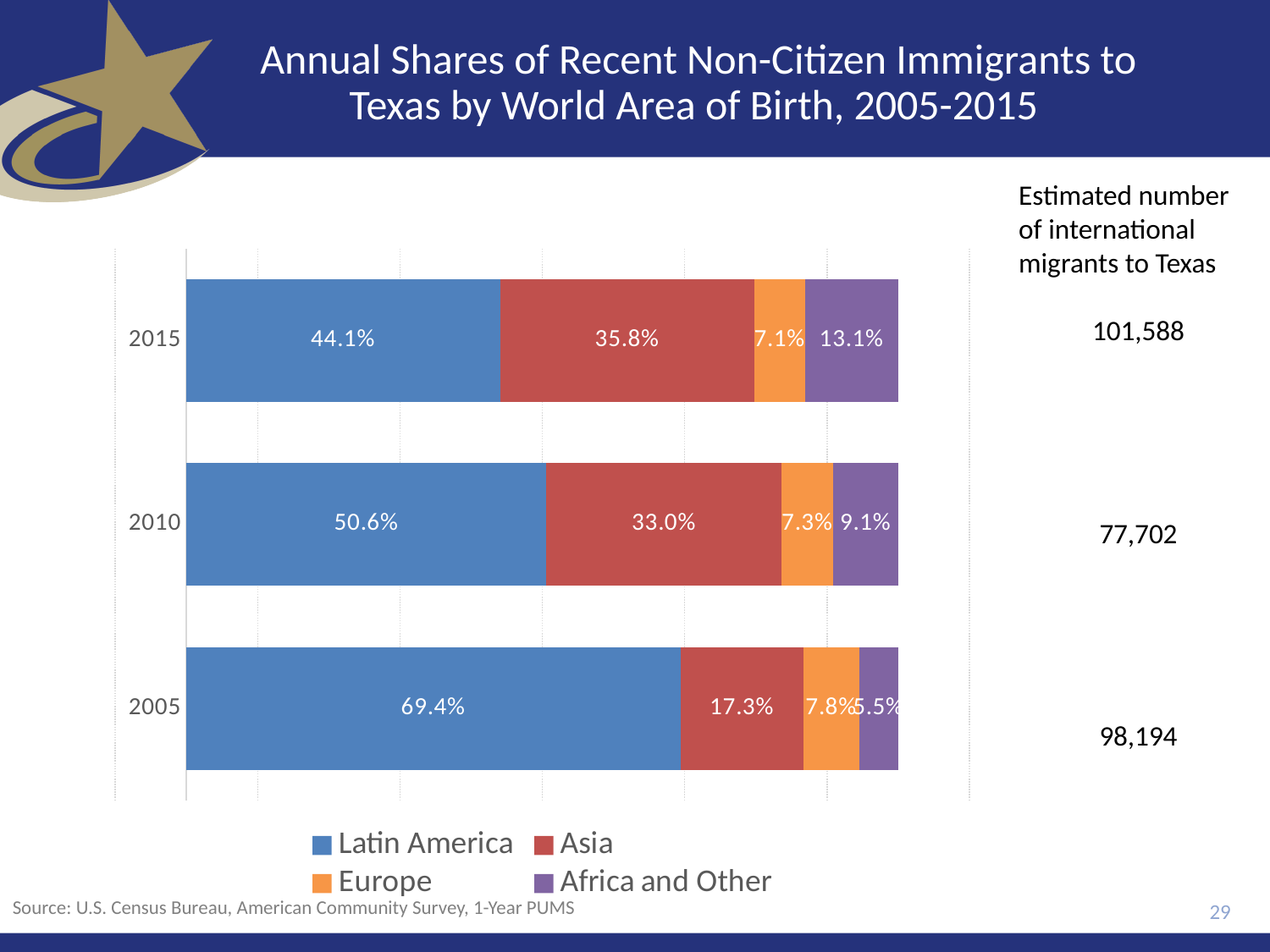
What share of recent non-citizen immigrants to Texas in 2015 were born in Latin America? 44.1% How many series does the legend list? 4 What kind of chart is shown on the slide? Stacked bar chart By how many percentage points did the Latin America share fall from 2005 to 2015? 25.3 percentage points What share of recent non-citizen immigrants to Texas in 2010 were born in Asia? 33.0% What share of recent non-citizen immigrants to Texas in 2015 were born in Africa and Other areas? 13.1% How many years are shown on the chart? 3 What is the estimated number of international migrants to Texas shown for 2010? 77,702 In which year was the Asia share of recent non-citizen immigrants to Texas lowest? 2005 In which year was the Latin America share of recent non-citizen immigrants to Texas highest? 2005 What share of recent non-citizen immigrants to Texas in 2005 were born in Europe? 7.8% Which was larger in 2010, the Europe share or the Africa and Other share? Africa and Other